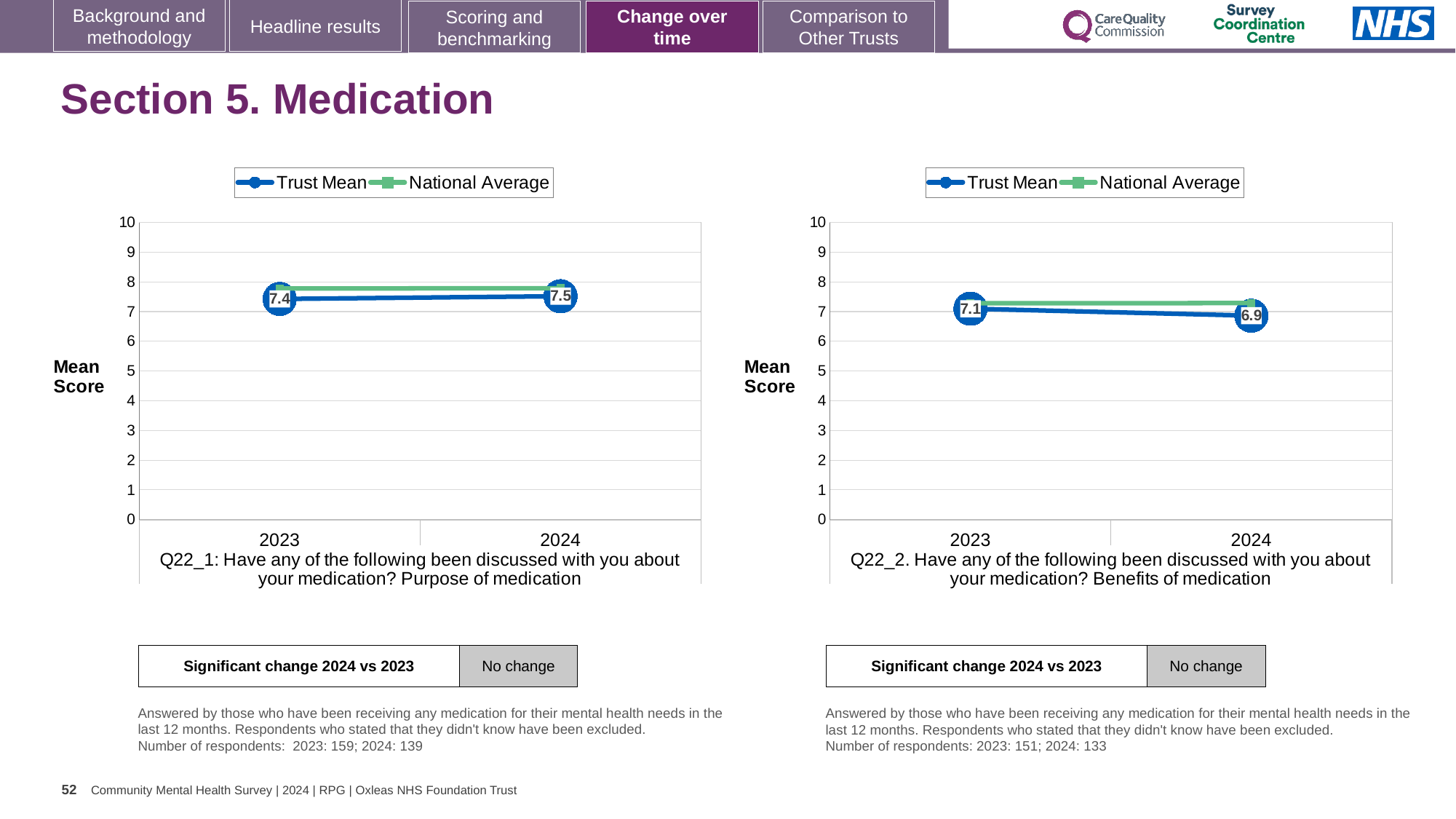
In the Q22_2 Benefits of medication chart, what is the difference between the Trust Mean in 2023 and 2024? 0.2 How many series does the legend of the Q22_2 Benefits of medication chart list? 2 In the Q22_1 Purpose of medication chart, does the Trust Mean rise or fall from 2023 to 2024? rise In the Q22_2 Benefits of medication chart, what is the Trust Mean for 2023? 7.1 What type of chart is used on the left of the slide for Q22_1? line chart In the Q22_1 Purpose of medication chart, what is the Trust Mean for 2024? 7.5 In the Q22_1 Purpose of medication chart, is the National Average for 2023 greater or less than 7? greater In the Q22_2 Benefits of medication chart, what is the Trust Mean for 2024? 6.9 In the Q22_2 Benefits of medication chart, which is larger in 2024, the Trust Mean or the National Average? National Average In the Q22_1 Purpose of medication chart, what is the Trust Mean for 2023? 7.4 In the Q22_1 Purpose of medication chart, by how much did the Trust Mean change from 2023 to 2024? 0.1 In the Q22_2 Benefits of medication chart, does the Trust Mean rise or fall from 2023 to 2024? fall